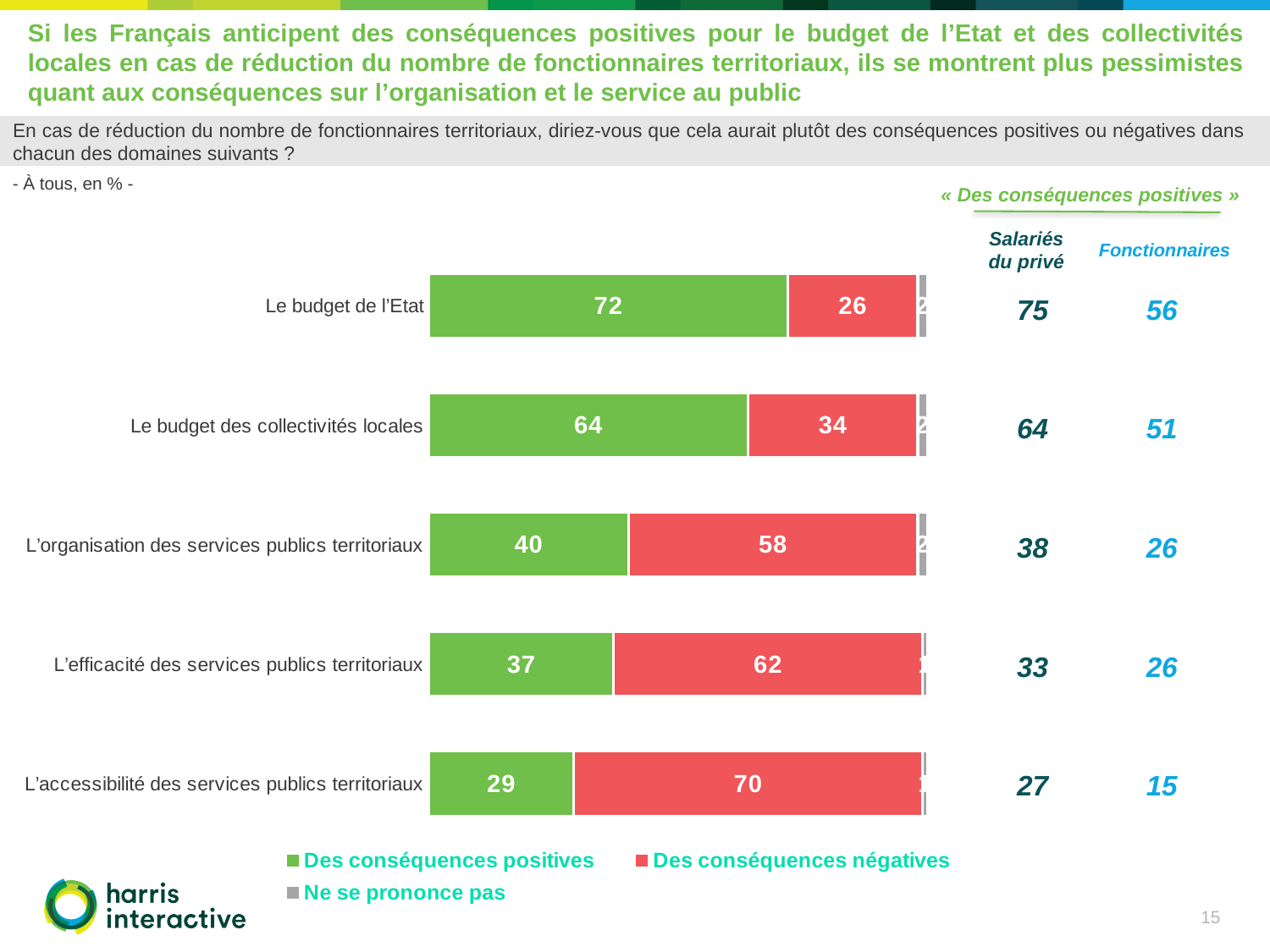
What is the difference between the 'Des conséquences négatives' and 'Des conséquences positives' values for 'L'organisation des services publics territoriaux'? 18 What kind of chart is shown on the slide? Stacked bar chart How many series does the legend list? 3 Which category has the highest value for 'Des conséquences positives'? Le budget de l'Etat What is the value for 'Des conséquences négatives' for 'L'accessibilité des services publics territoriaux'? 70 What percentage of respondents expect positive consequences for 'Le budget de l'Etat'? 72 Which category has the lowest value for 'Des conséquences négatives'? Le budget de l'Etat How many categories are shown in the bar chart? 5 For 'Le budget des collectivités locales', which is larger: 'Des conséquences positives' or 'Des conséquences négatives'? Des conséquences positives What is the value for 'Des conséquences positives' for 'L'efficacité des services publics territoriaux'? 37 In the side table, what is the 'Fonctionnaires' value for 'L'accessibilité des services publics territoriaux'? 15 Which colour represents 'Des conséquences négatives' in the chart? Red